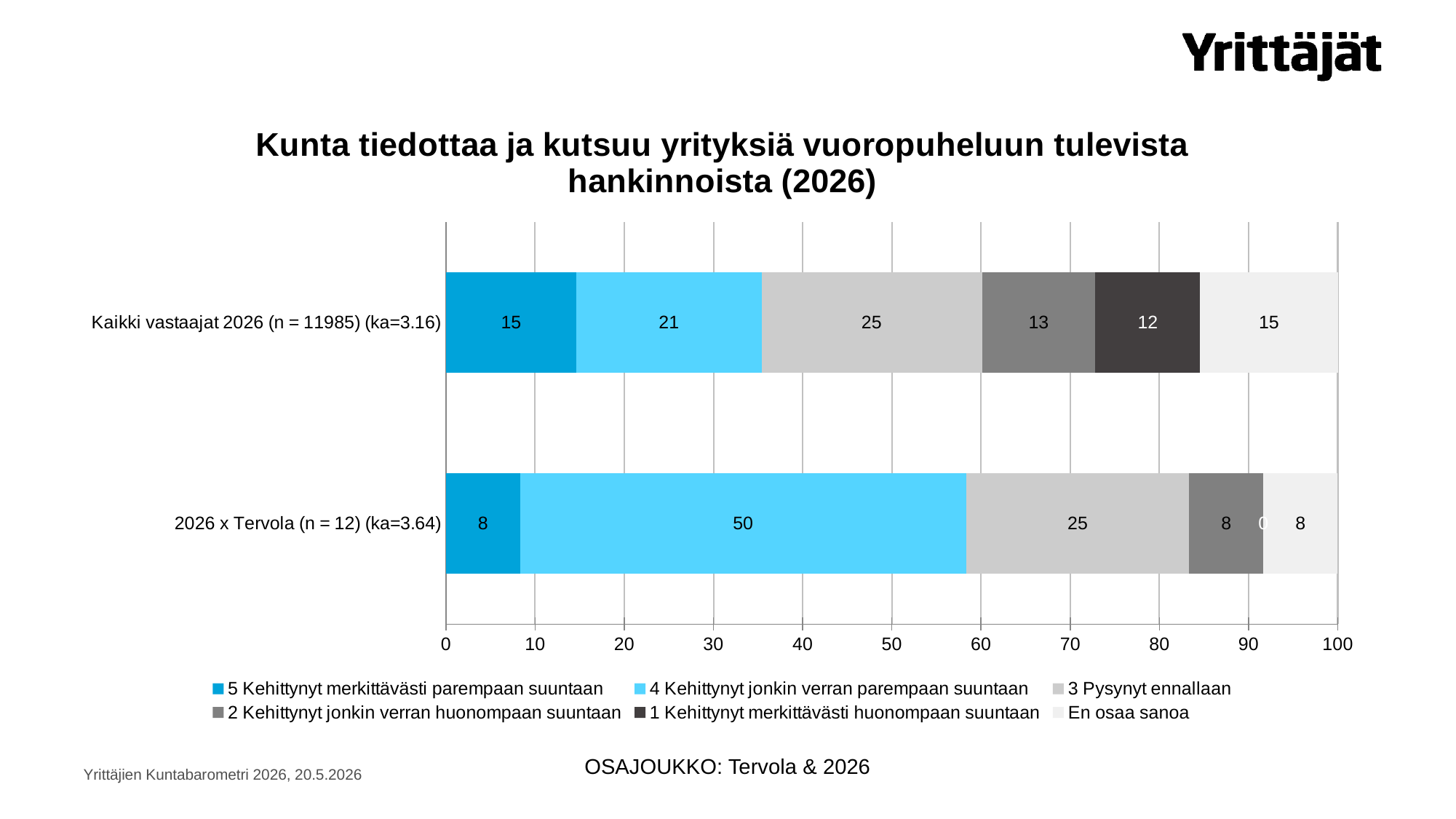
How many series does the legend list? 6 What is the title of the chart? Kunta tiedottaa ja kutsuu yrityksiä vuoropuheluun tulevista hankinnoista (2026) What is the difference between the '4 Kehittynyt jonkin verran parempaan suuntaan' values for '2026 x Tervola' and 'Kaikki vastaajat 2026'? 29 What is the value for '4 Kehittynyt jonkin verran parempaan suuntaan' in the '2026 x Tervola (n = 12) (ka=3.64)' bar? 50 Which bar has the larger value for '5 Kehittynyt merkittävästi parempaan suuntaan': 'Kaikki vastaajat 2026' or '2026 x Tervola'? Kaikki vastaajat 2026 (n = 11985) (ka=3.16) What kind of chart is shown on the slide? Stacked bar chart Which series has the largest value in the 'Kaikki vastaajat 2026 (n = 11985) (ka=3.16)' bar? 3 Pysynyt ennallaan What is the value for '3 Pysynyt ennallaan' in the 'Kaikki vastaajat 2026 (n = 11985) (ka=3.16)' bar? 25 How many bars (categories) are shown in the chart? 2 What is the value for '1 Kehittynyt merkittävästi huonompaan suuntaan' in the '2026 x Tervola (n = 12) (ka=3.64)' bar? 0 Which series has the largest value in the '2026 x Tervola (n = 12) (ka=3.64)' bar? 4 Kehittynyt jonkin verran parempaan suuntaan What is the value for 'En osaa sanoa' in the 'Kaikki vastaajat 2026 (n = 11985) (ka=3.16)' bar? 15